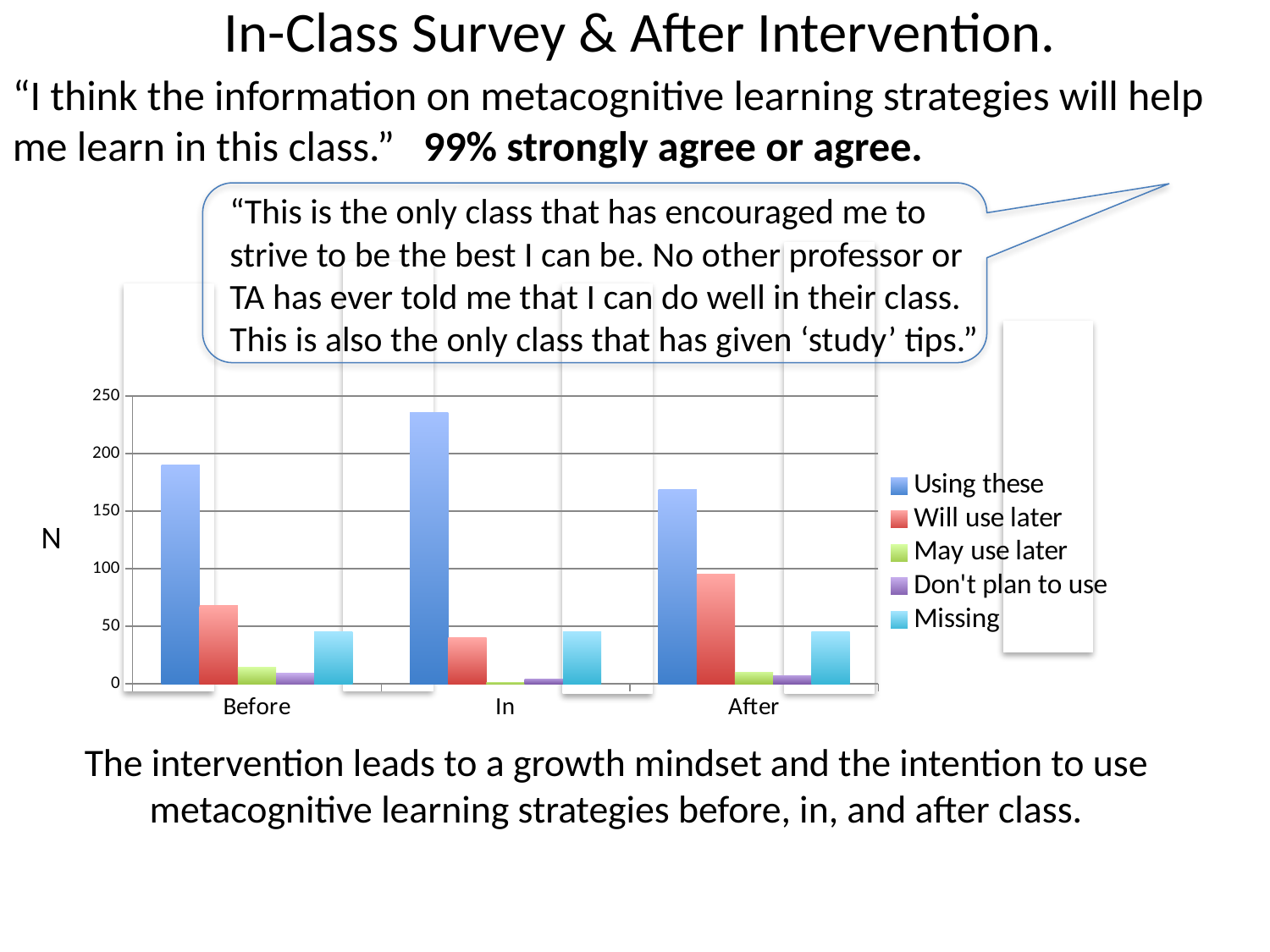
What is the label on the y axis of the chart? N How many categories are shown on the x axis of the chart? 3 In which category is the value for "Will use later" highest? After Is the value for "Will use later" in the Before category greater or less than 50? greater How many series does the chart's legend list? 5 Which is larger in the After category: "Will use later" or "Missing"? Will use later Which is larger in the Before category: "Using these" or "Will use later"? Using these Is the value for "Using these" in the In category greater or less than 200? greater In which category is the value for "Will use later" lowest? In Is the value for "Using these" in the After category greater or less than 200? less What kind of chart is shown on the slide? bar chart In which category is the value for "Using these" highest? In